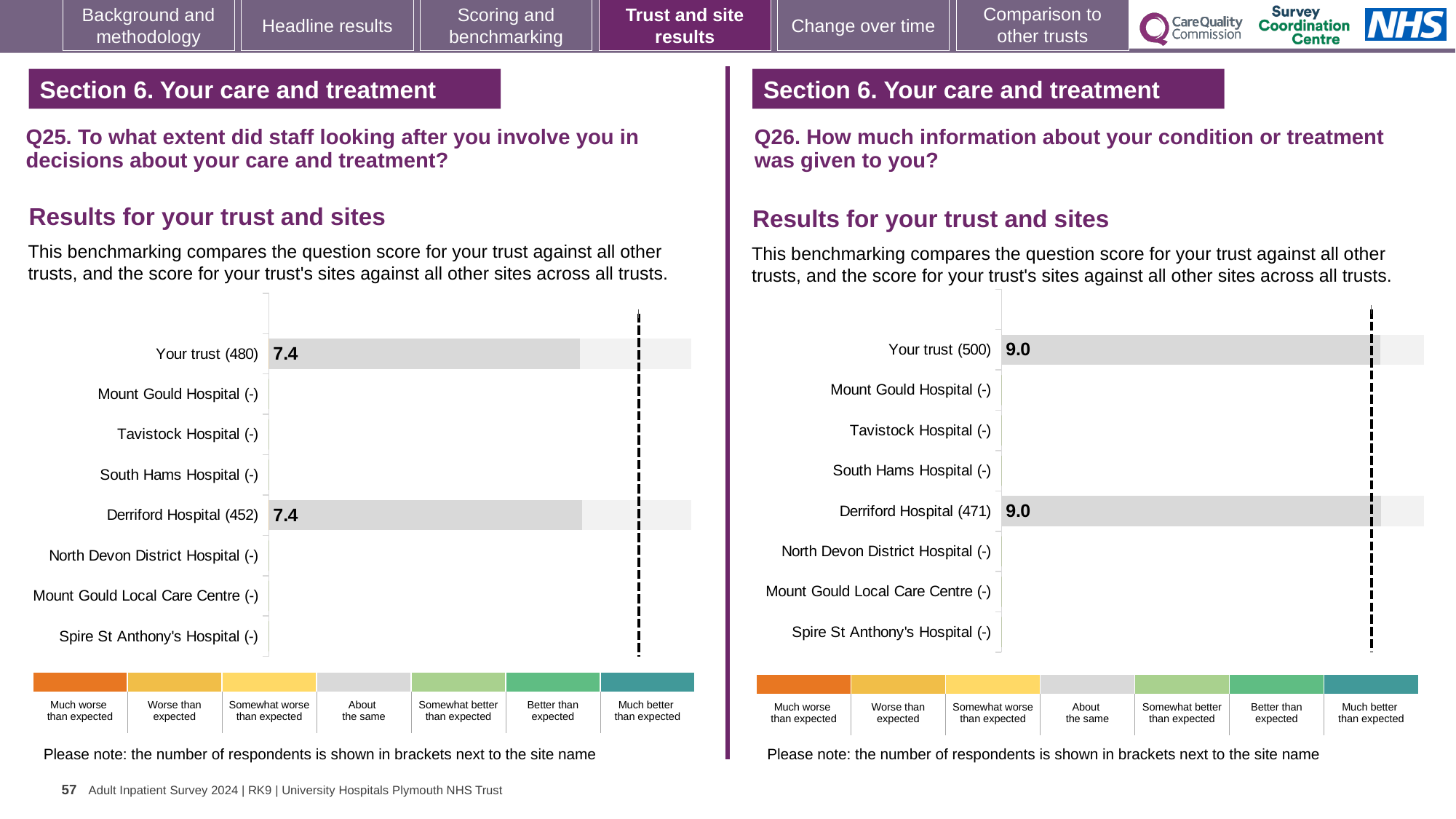
In the Q25 chart on the left, what is the score for Your trust? 7.4 In the Q26 chart on the right, what is the score for Your trust? 9.0 In the Q26 chart on the right, how many categories have a bar with a printed score? 2 In the Q26 chart on the right, how many respondents are shown in brackets for Your trust? 500 In the Q26 chart on the right, what is the score for Derriford Hospital? 9.0 How many site or trust categories are listed on the y axis of the Q25 chart on the left? 8 In the Q25 chart on the left, how many respondents are shown in brackets for Derriford Hospital? 452 In the Q25 chart on the left, what is the difference between the score for Your trust and the score for Derriford Hospital? 0.0 What kind of chart is used for the Q26 results on the right? Bar chart Is the score for Your trust in the Q26 chart on the right larger than the score for Your trust in the Q25 chart on the left? Yes In the Q25 chart on the left, what is the score for Derriford Hospital? 7.4 How many colour bands are shown in the benchmarking key below the Q25 chart on the left? 7